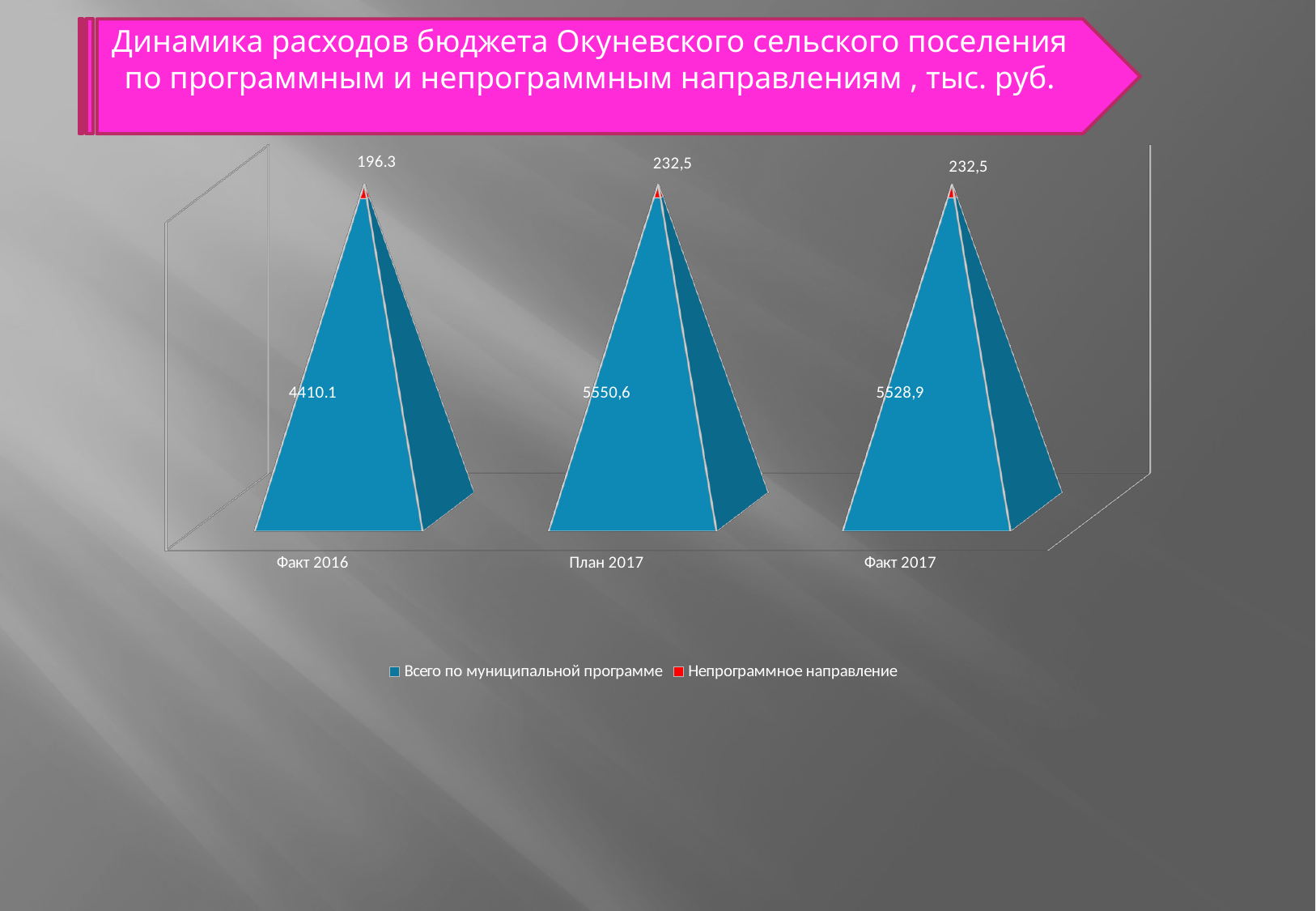
What is the value for "Всего по муниципальной программе" for Факт 2016? 4410.1 Which is larger: the "Всего по муниципальной программе" value for Факт 2016 or for Факт 2017? Факт 2017 What is the value for "Непрограммное направление" for План 2017? 232,5 How many series does the legend list? 2 Which category has the lowest value for "Непрограммное направление"? Факт 2016 Which category has the highest value for "Всего по муниципальной программе"? План 2017 What is the value for "Всего по муниципальной программе" for Факт 2017? 5528,9 What is the difference between the "Всего по муниципальной программе" values for План 2017 and Факт 2017? 21,7 What is the total of the stacked bar for План 2017? 5783,1 How many categories are shown on the x axis? 3 What kind of chart is shown on the slide? Stacked bar chart What is the value for "Непрограммное направление" for Факт 2016? 196.3